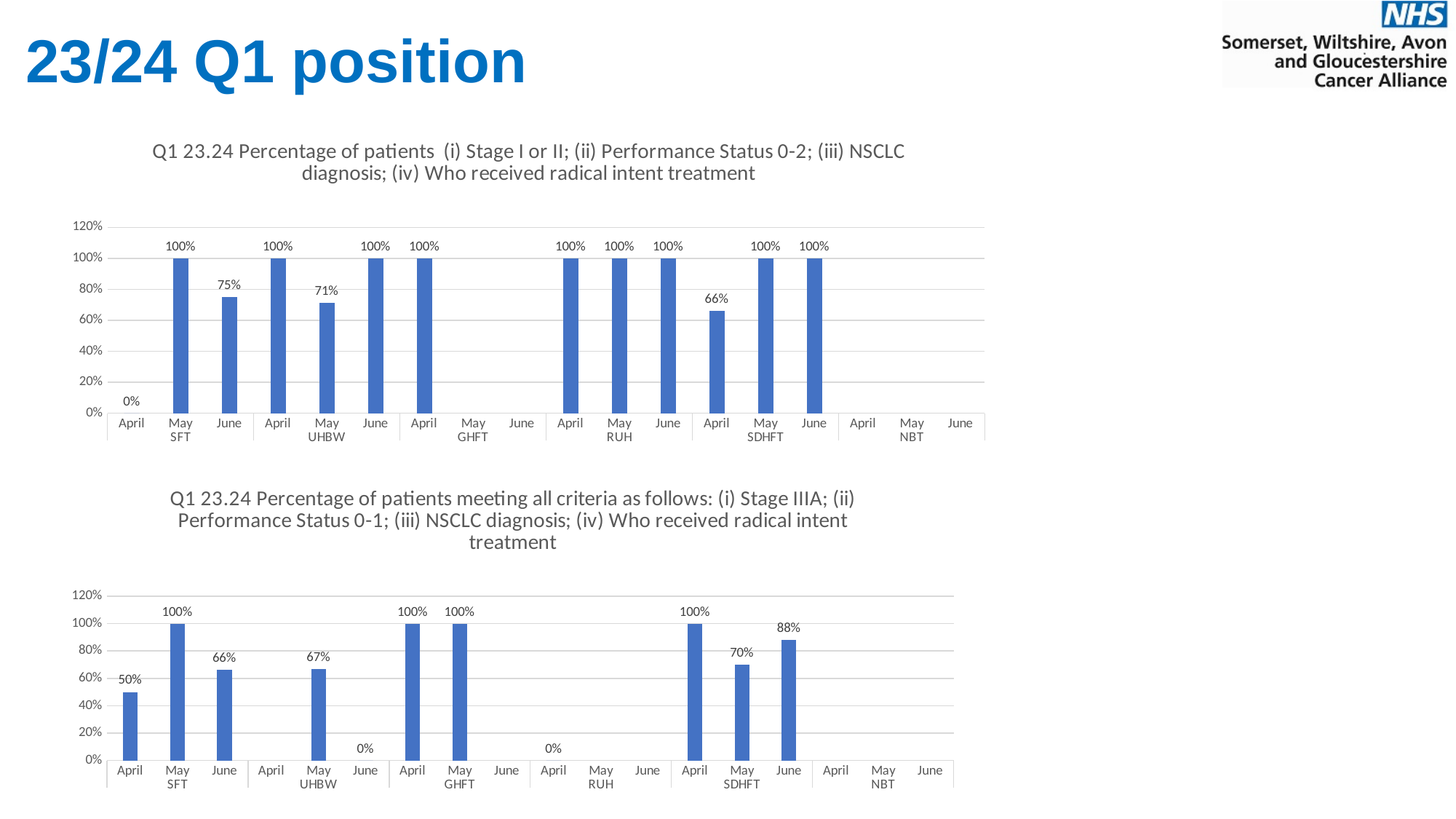
In the bottom chart, what is the value for SDHFT in June? 88% In the top chart, what is the value for UHBW in May? 71% In the bottom chart, what is the value for UHBW in May? 67% How many trusts are listed along the x axis of the bottom chart? 6 In the bottom chart, what is the value for SFT in April? 50% In the top chart, what is the difference between SFT in June and SDHFT in April? 9% In the top chart, what is the value for SDHFT in April? 66% In the top chart, what is the value for SFT in April? 0% In the top chart, what is the value for SFT in June? 75% In the bottom chart, which is larger: SDHFT in May or SFT in June? SDHFT in May In the bottom chart, what is the difference between SDHFT in June and SDHFT in May? 18% What type of chart is the top chart? Bar chart